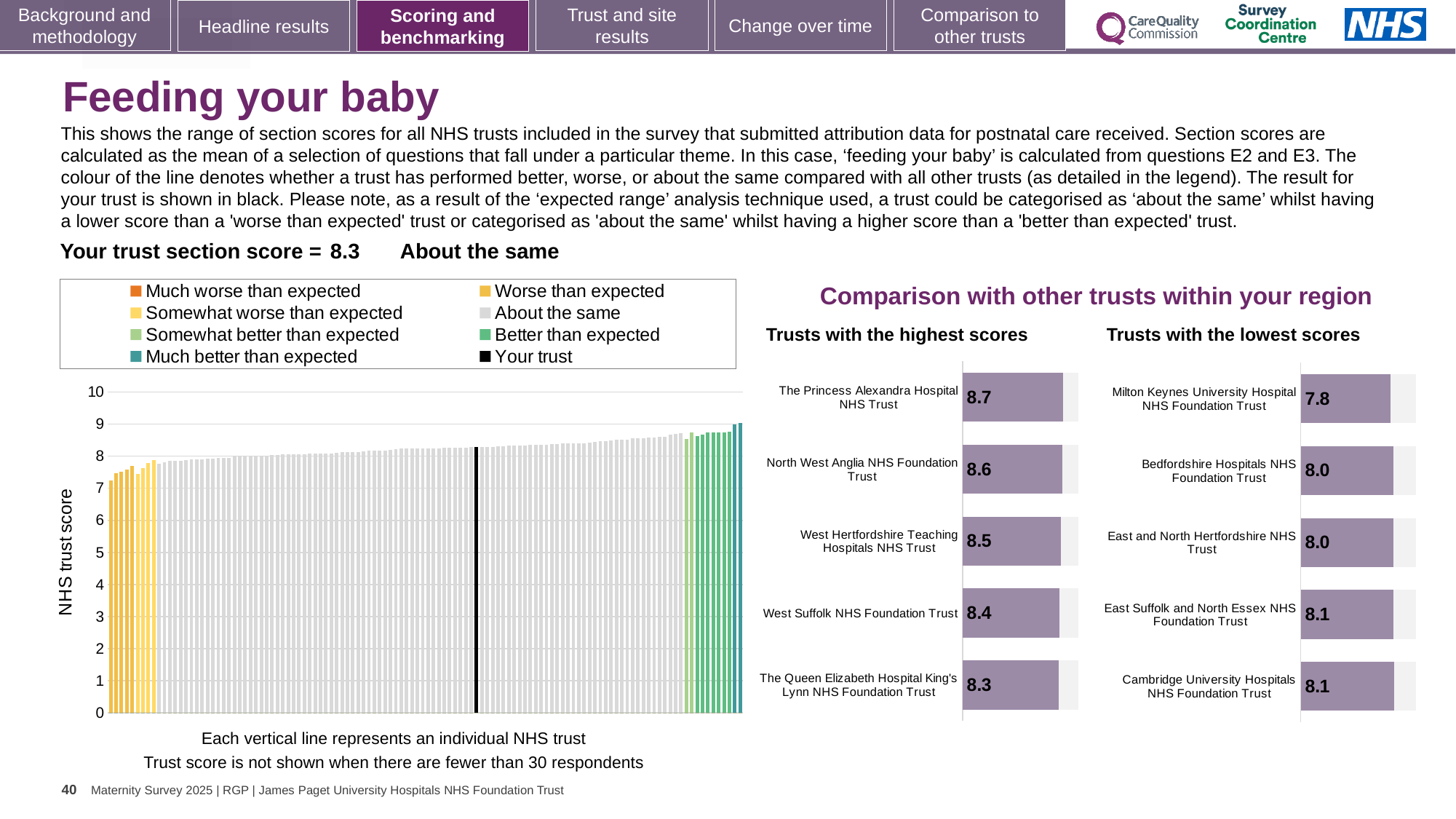
In the main 'NHS trust score' chart, do the bar values rise or fall from left to right? rise How many entries does the legend of the main 'NHS trust score' chart list? 8 In the 'Trusts with the lowest scores' chart, which has the higher score: Milton Keynes University Hospital NHS Foundation Trust or East Suffolk and North Essex NHS Foundation Trust? East Suffolk and North Essex NHS Foundation Trust In the 'Trusts with the highest scores' chart, which trust has the highest score? The Princess Alexandra Hospital NHS Trust How many trusts are listed in the 'Trusts with the highest scores' chart? 5 In the 'Trusts with the highest scores' chart, what is the score for West Suffolk NHS Foundation Trust? 8.4 In the 'Trusts with the highest scores' chart, what is the difference between the scores of The Princess Alexandra Hospital NHS Trust and The Queen Elizabeth Hospital King's Lynn NHS Foundation Trust? 0.4 In the 'Trusts with the highest scores' chart, what is the score for The Princess Alexandra Hospital NHS Trust? 8.7 In the 'Trusts with the lowest scores' chart, which trust has the lowest score? Milton Keynes University Hospital NHS Foundation Trust In the 'Trusts with the lowest scores' chart, what is the score for Cambridge University Hospitals NHS Foundation Trust? 8.1 In the 'Trusts with the lowest scores' chart, what is the score for Milton Keynes University Hospital NHS Foundation Trust? 7.8 In the main 'NHS trust score' chart, is the value for the black bar (your trust) greater or less than 8? greater